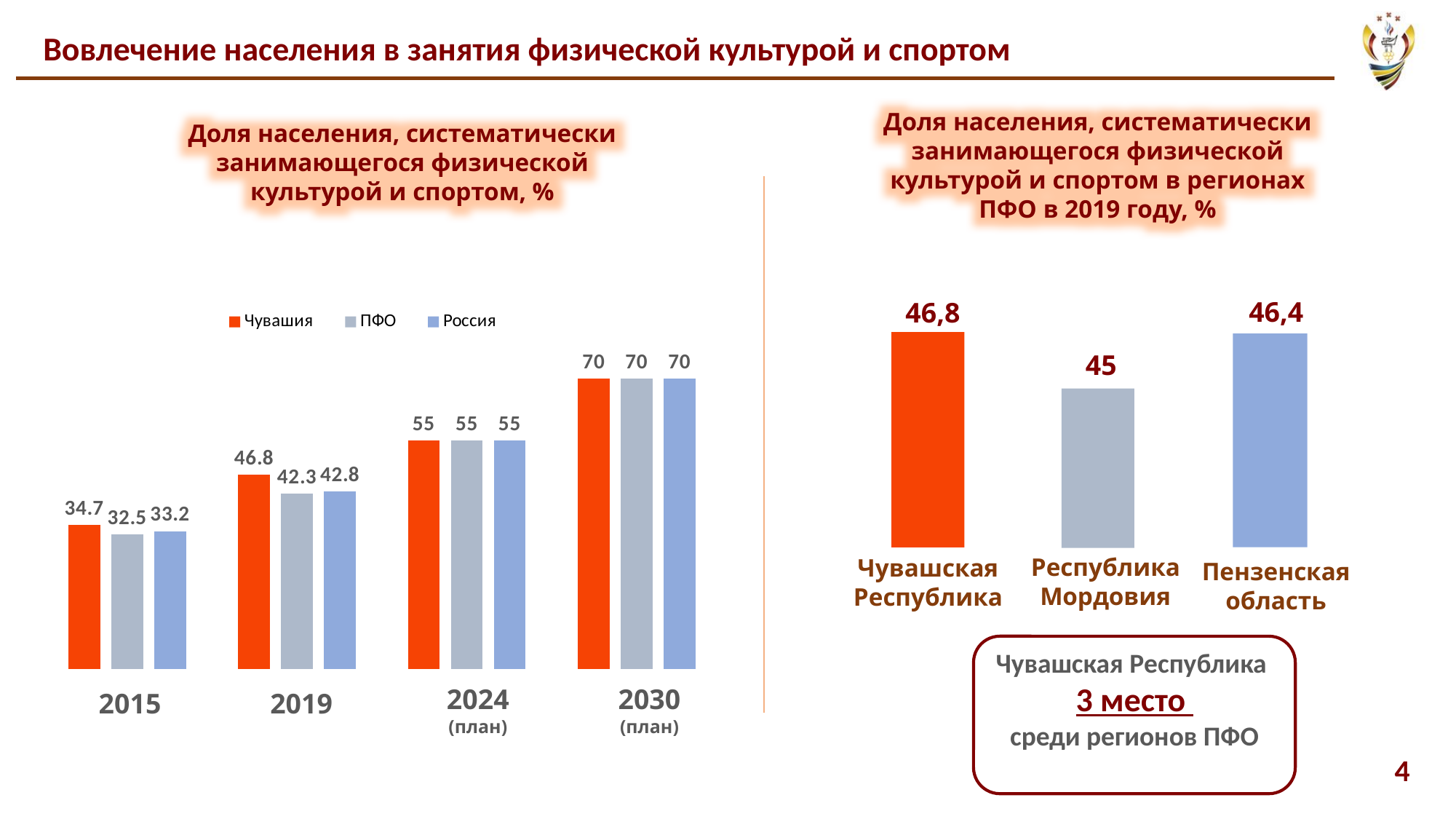
In the left chart, what is the value for ПФО in 2015? 32.5 In the left chart, which is larger in 2015: Чувашия or Россия? Чувашия What kind of chart is the right chart? bar chart In the right chart, which region has the highest value? Чувашская Республика In the left chart (Доля населения, систематически занимающегося физической культурой и спортом, %), what is the value for Чувашия in 2019? 46.8 In the right chart, which region has the lowest value? Республика Мордовия In the left chart, what is the difference between Чувашия and ПФО in 2019? 4.5 In the left chart, do the values for Чувашия rise or fall from 2015 to 2030? rise In the left chart, how many year categories are shown on the x axis? 4 In the right chart (regions of ПФО in 2019), what is the value for Республика Мордовия? 45 In the left chart, what is the value for Россия in 2024 (план)? 55 In the left chart, how many series does the legend list? 3